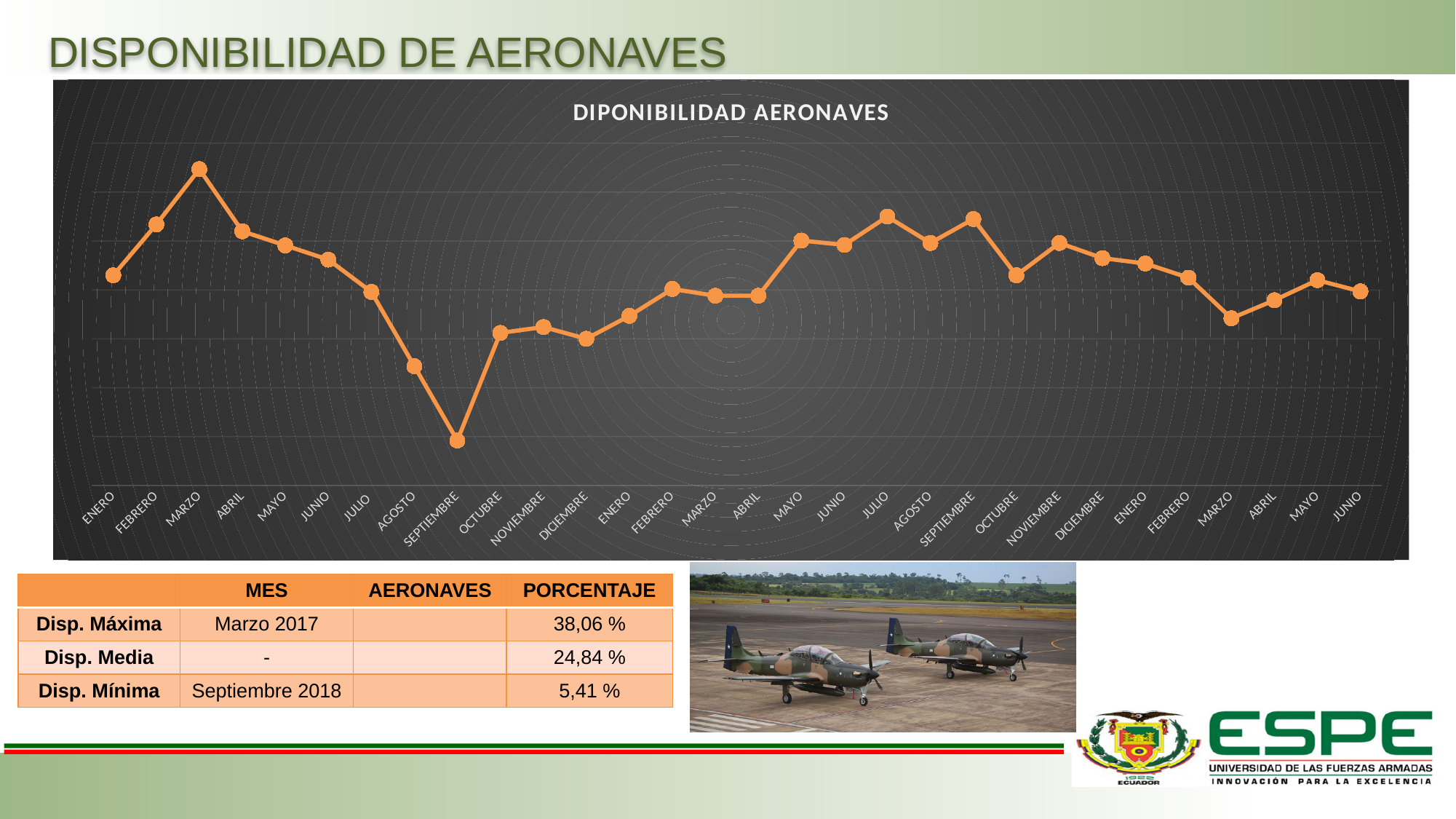
Which is higher on the line chart, the second ABRIL or the second MAYO? the second MAYO What is the title of the chart? DIPONIBILIDAD AERONAVES Which is higher on the line chart, the second JULIO or the second OCTUBRE? the second JULIO How many data points are plotted on the line chart? 30 What kind of chart is shown on the slide? line chart Which is higher on the line chart, the first JULIO or the first AGOSTO? the first JULIO Does the line rise or fall from the first SEPTIEMBRE to the first OCTUBRE? rise Does the line rise or fall from the first MARZO to the first SEPTIEMBRE? fall Does the line rise or fall from the last MAYO to the last JUNIO? fall Which month has the highest value on the line chart? the first MARZO Which month has the lowest value on the line chart? the first SEPTIEMBRE